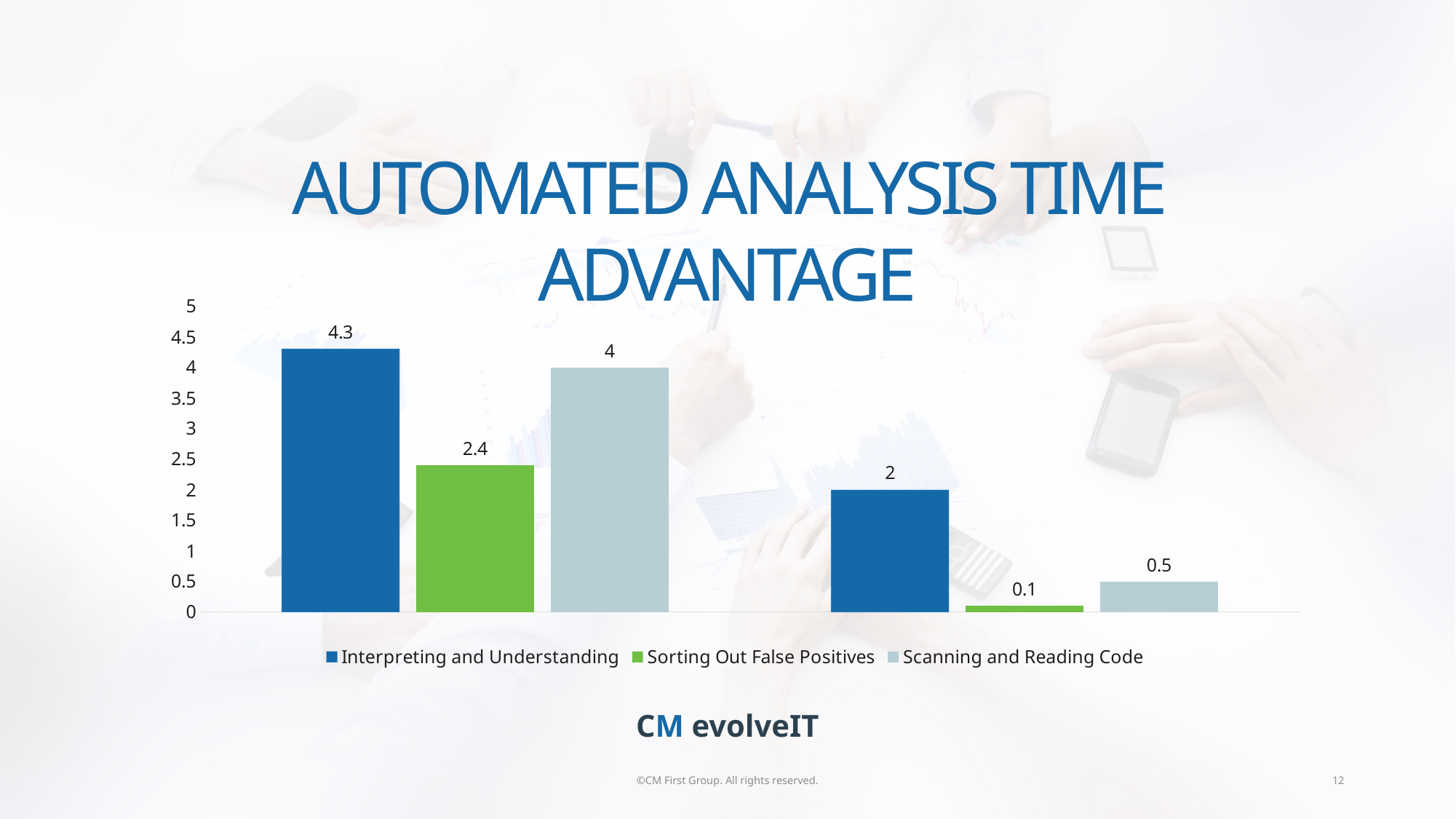
How many bars are plotted in the chart? 6 What is the title of the chart on the slide? Automated Analysis Time Advantage What is the value of the Sorting Out False Positives bar in the left group? 2.4 Which bar has the lowest value in the chart? Sorting Out False Positives (right group), 0.1 What is the difference between the Interpreting and Understanding values in the left group and the right group? 2.3 In the left group, which is larger: Scanning and Reading Code or Sorting Out False Positives? Scanning and Reading Code What is the value of the Interpreting and Understanding bar in the left group? 4.3 What is the value of the Scanning and Reading Code bar in the right group? 0.5 How many series does the legend list? 3 What is the value of the Sorting Out False Positives bar in the right group? 0.1 What type of chart is shown on the slide? bar chart Which bar has the highest value in the chart? Interpreting and Understanding (left group), 4.3